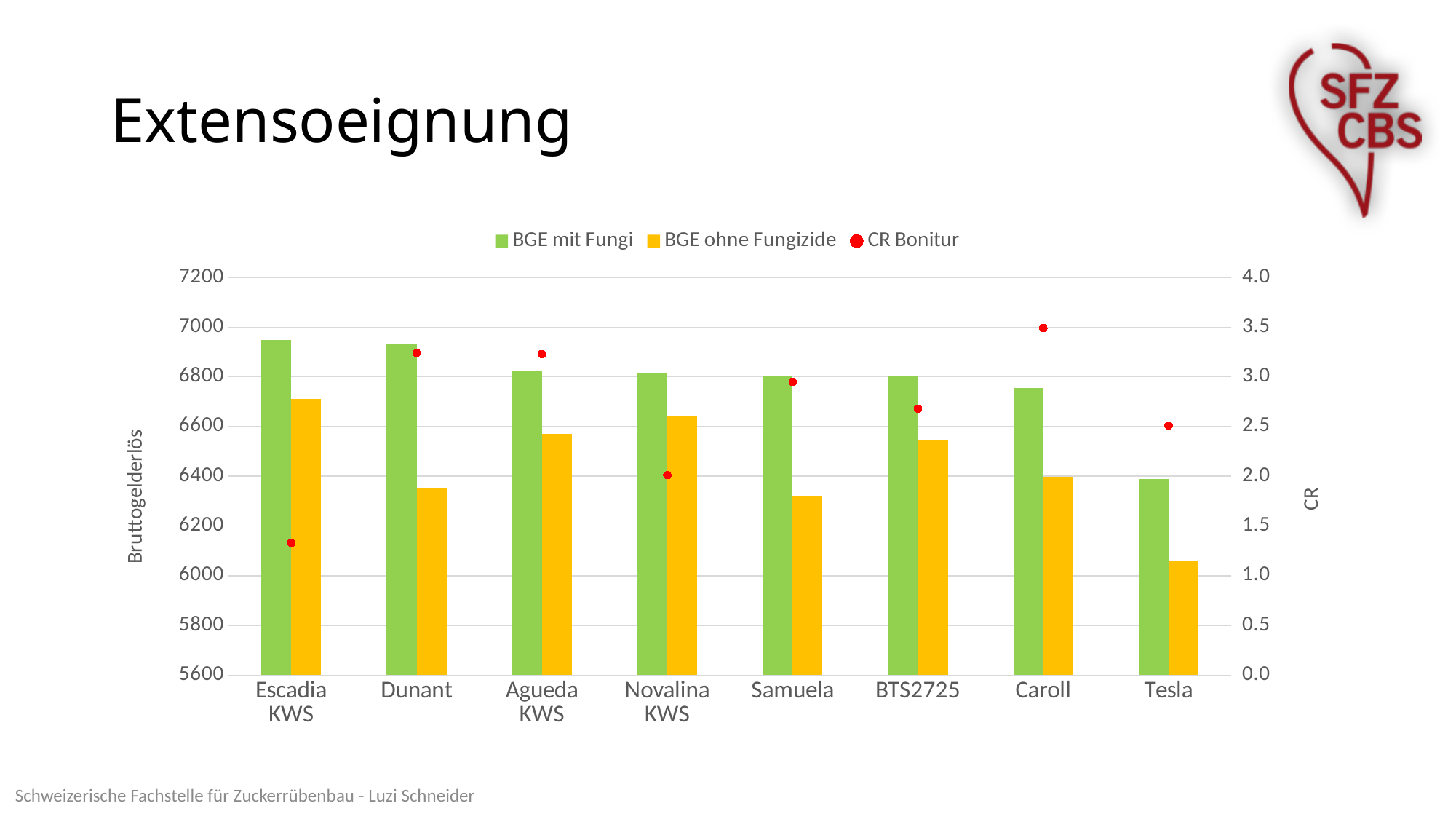
Is the BGE mit Fungi value for Escadia KWS greater or less than 6800? greater Is the CR Bonitur value for Caroll greater or less than 3.0? greater How many series does the legend list? 3 Which is larger, the BGE ohne Fungizide value for Novalina KWS or for Dunant? Novalina KWS What kind of chart is shown on the slide? Bar chart with a point series (CR Bonitur) on a secondary axis How many varieties (categories) are shown on the x axis? 8 Which variety has the lowest BGE ohne Fungizide value? Tesla Which variety has the highest CR Bonitur value? Caroll What is the label of the left vertical axis? Bruttogelderlös Which variety has the lowest BGE mit Fungi value? Tesla Is the BGE ohne Fungizide value for Tesla greater or less than 6200? less Which variety has the lowest CR Bonitur value? Escadia KWS